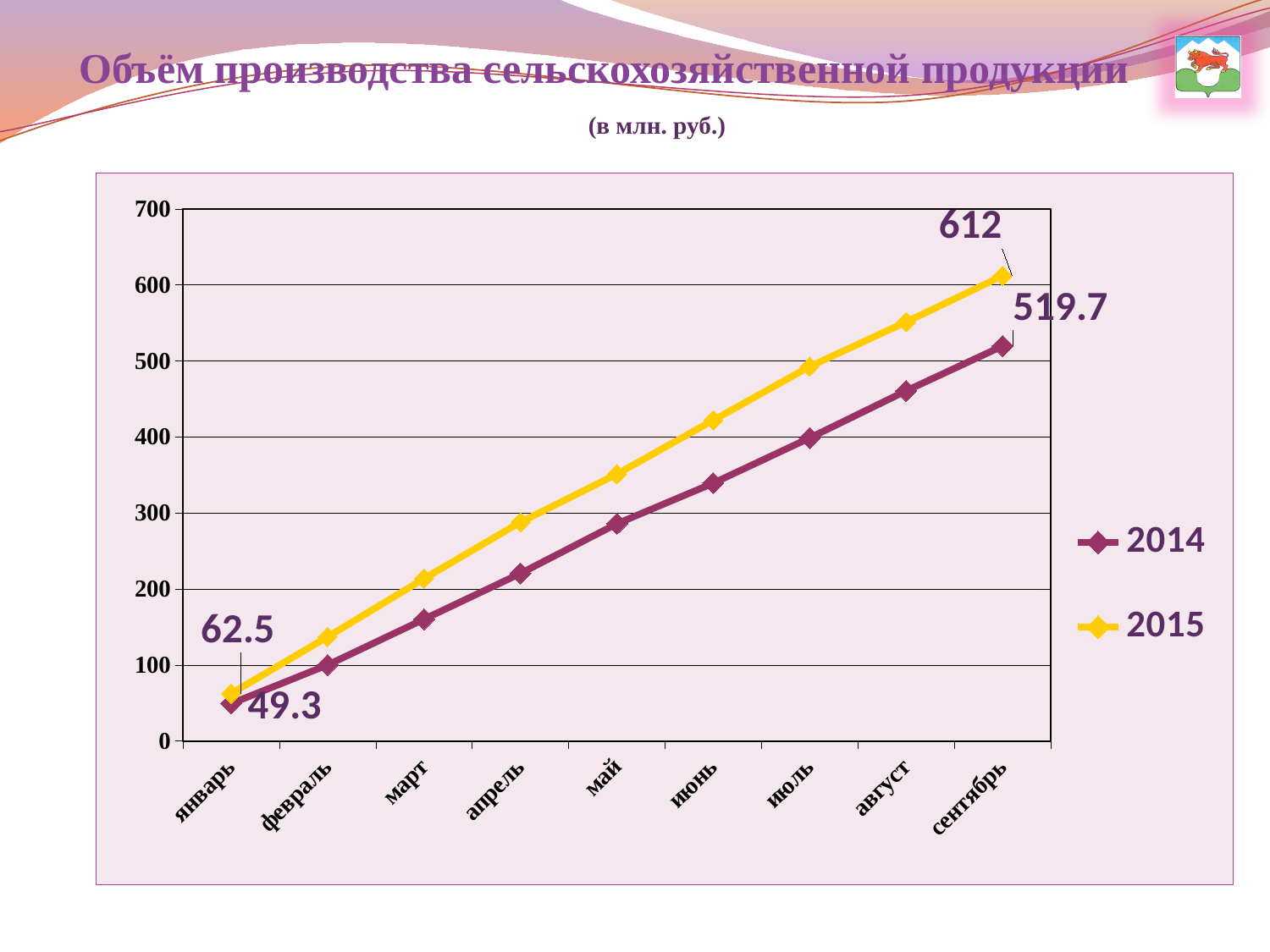
Is the value for 2015 in июль greater or less than 400? greater What kind of chart is shown on the slide? line chart What is the value for 2014 in сентябрь? 519.7 Which series has the larger value in сентябрь, 2014 or 2015? 2015 What is the value for 2015 in январь? 62.5 Is the value for 2014 in май greater or less than 300? less What is the value for 2015 in сентябрь? 612 What is the difference between the 2015 and 2014 values in сентябрь? 92.3 How many months are shown on the x axis? 9 What is the difference between the 2015 and 2014 values in январь? 13.2 What is the value for 2014 in январь? 49.3 How many series does the legend list? 2